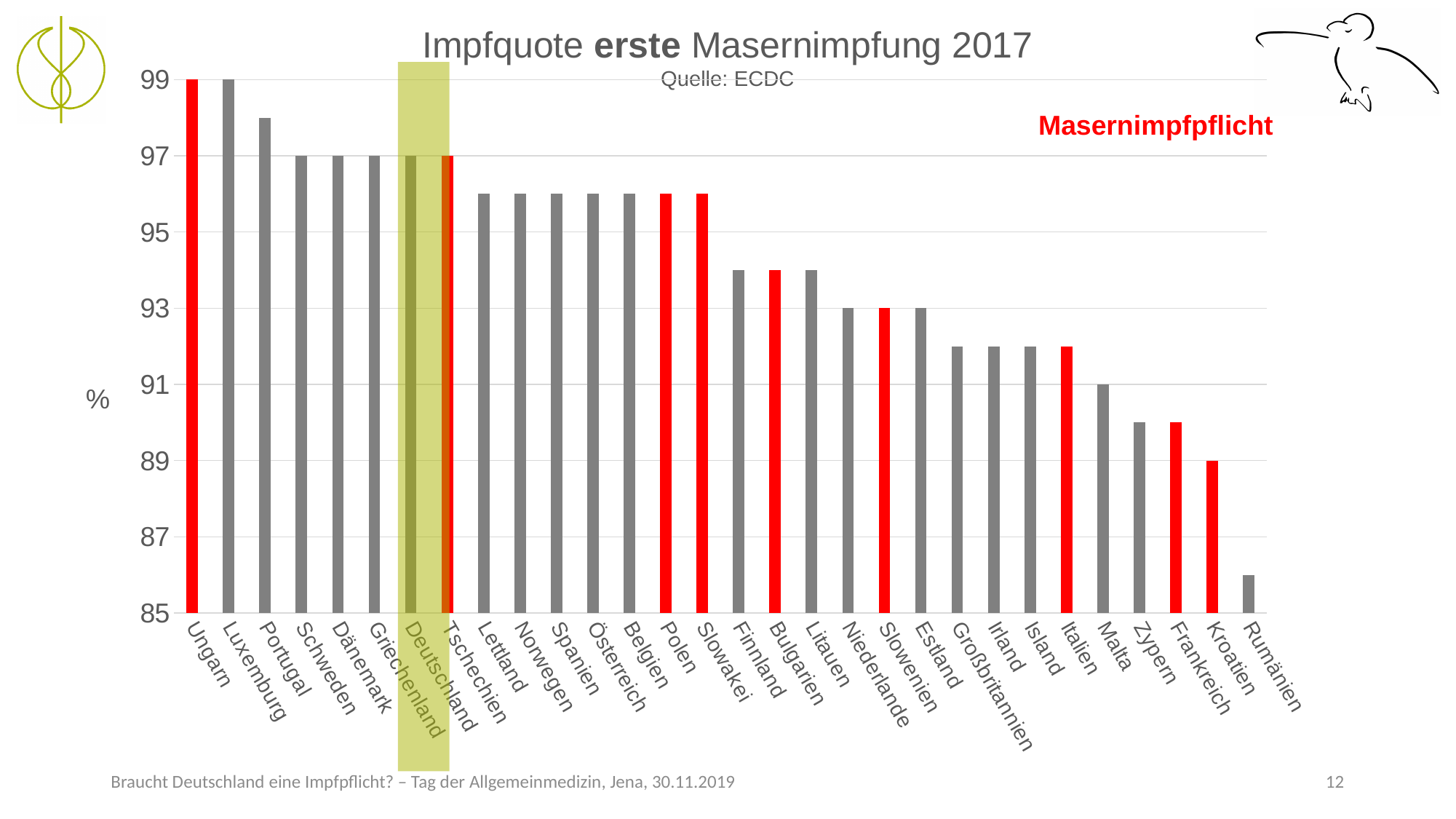
What is the value for Kroatien? 89 Which country has the lowest value? Rumänien What kind of chart is shown on the slide? bar chart Do the values rise or fall from left to right along the x axis? fall Which country is highlighted with a yellow-green band in the chart? Deutschland What is the value for Deutschland? 97 How many countries are shown in the chart? 30 What is the difference between the values for Ungarn and Kroatien? 10 What is the value for Ungarn? 99 Is the value for Polen greater or less than 95? greater Which is larger, the value for Deutschland or the value for Frankreich? Deutschland Is the value for Rumänien greater or less than 87? less